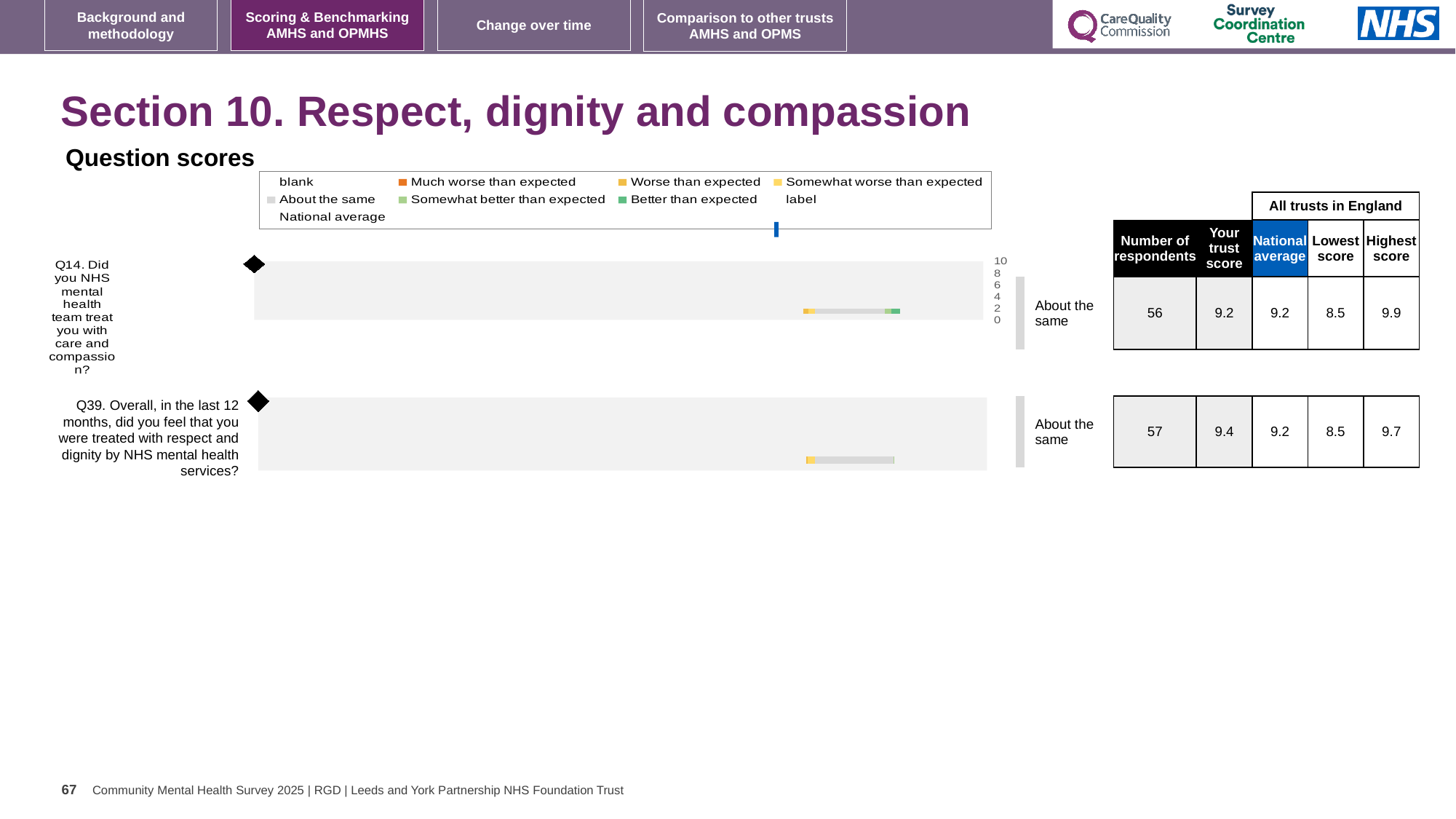
Which question has the higher trust score, Q14 or Q39? Q39 What is the highest score among all trusts in England for Q14? 9.9 What is the national average score for Q39? 9.2 What benchmark category label is shown next to the bar for Q14? About the same What is the number of respondents for Q39? 57 What is the 'Your trust score' for Q14 (care and compassion)? 9.2 What is the 'Your trust score' for Q39 (respect and dignity)? 9.4 What is the number of respondents for Q14? 56 What is the difference between the highest score and the lowest score for Q39? 1.2 How many entries does the legend of the Question scores chart list? 9 How many questions (categories) are plotted in the Question scores chart? 2 What kind of chart is shown under 'Question scores'? bar chart